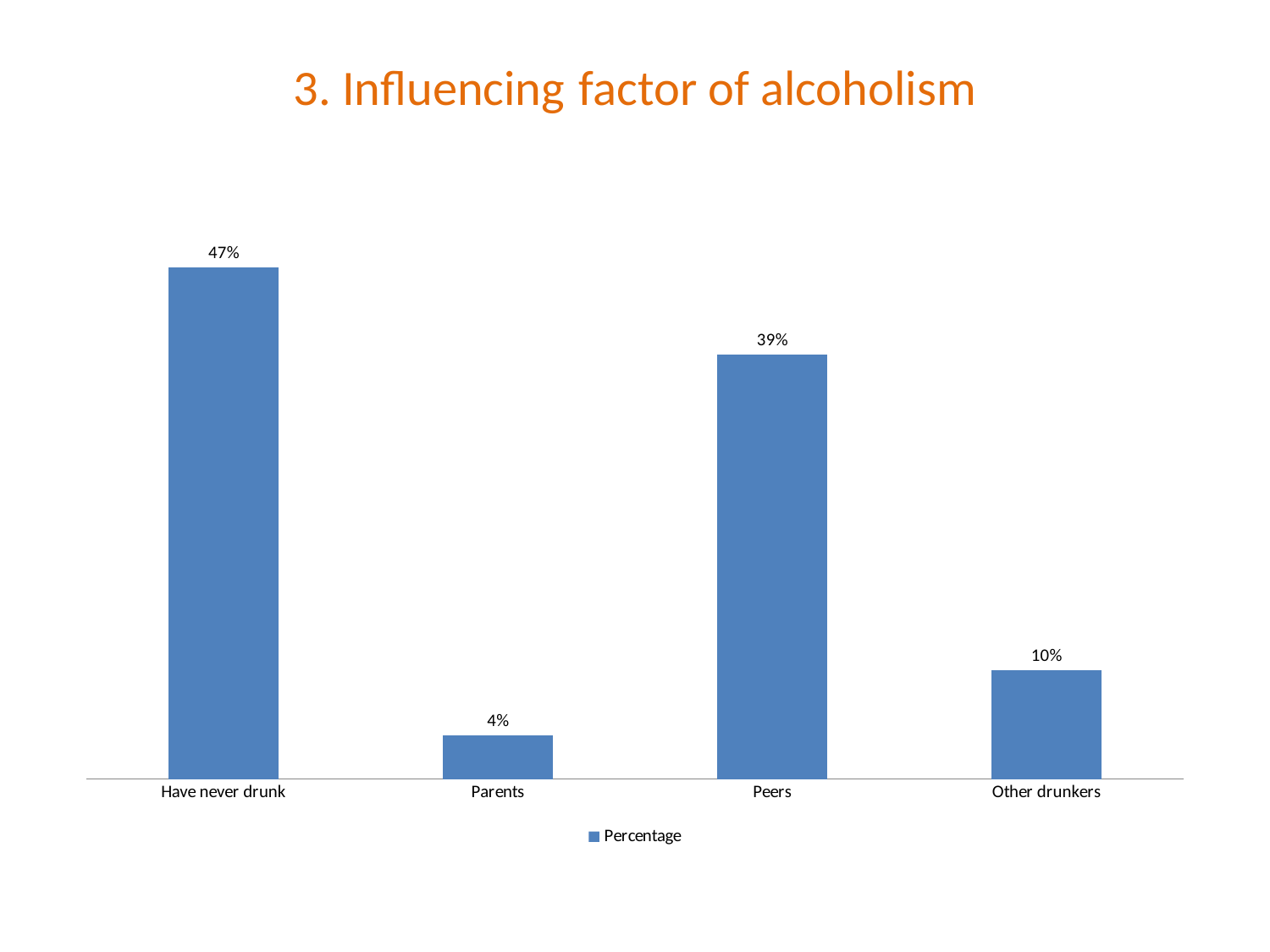
Which category has the highest percentage? Have never drunk What series name does the legend show? Percentage Which category has the lowest percentage? Parents What is the percentage for Parents? 4% What is the difference in percentage between Have never drunk and Peers? 8% What is the percentage for Other drunkers? 10% What is the difference in percentage between Other drunkers and Parents? 6% What is the percentage for Have never drunk? 47% Which is larger, the percentage for Peers or for Other drunkers? Peers What kind of chart is shown on the slide? Bar chart How many categories are shown in the chart? 4 What is the percentage for Peers? 39%